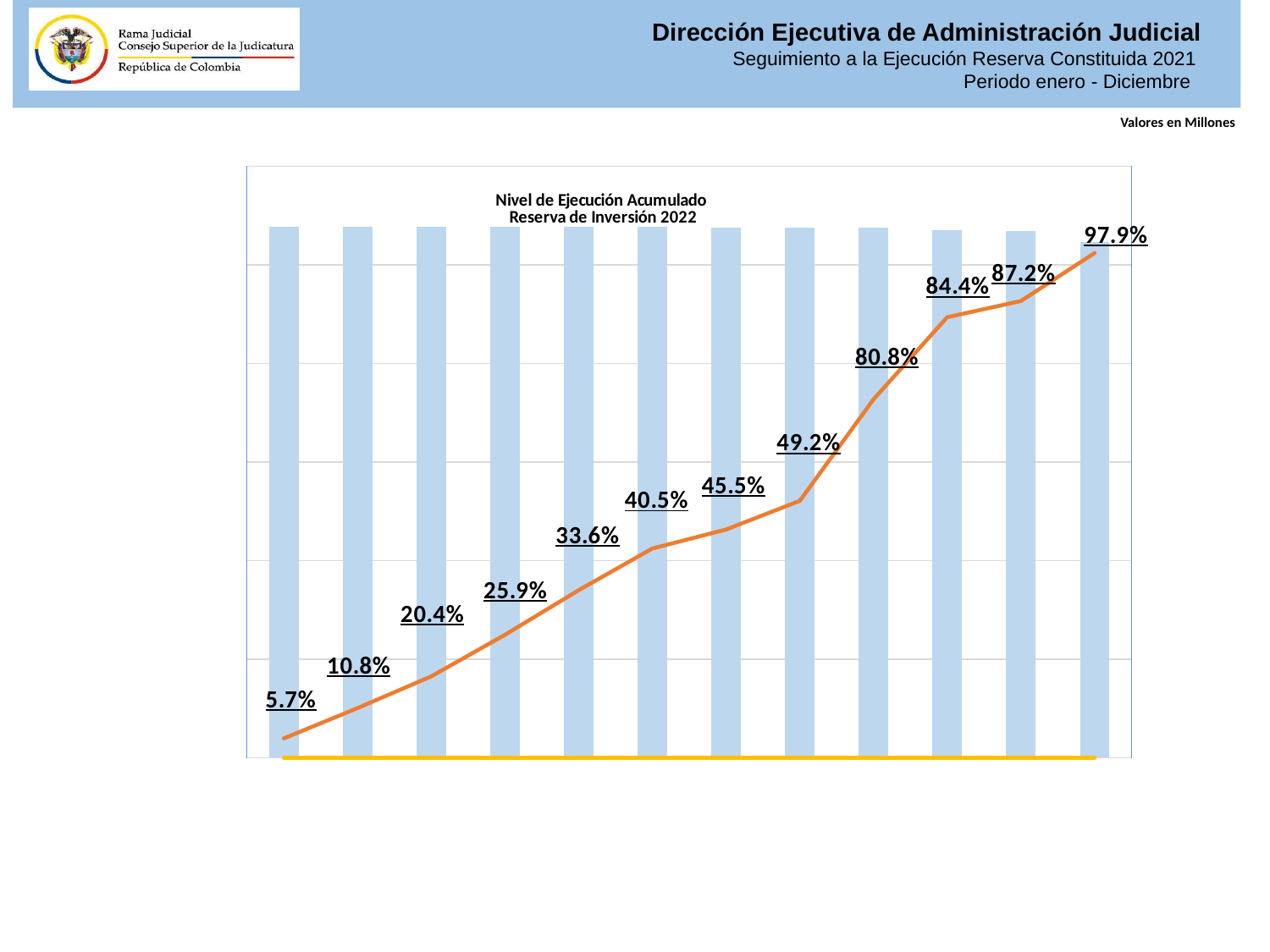
How many data points are labelled on the line? 12 Do the values rise or fall from left to right along the line? rise What is the value of the fifth data point on the line? 33.6% What is the value of the first data point on the line? 5.7% What is the difference between the ninth data point (80.8%) and the eighth data point (49.2%)? 31.6 percentage points What is the lowest value labelled on the line? 5.7% What is the title of the chart? Nivel de Ejecución Acumulado Reserva de Inversión 2022 What is the value of the ninth data point on the line? 80.8% What is the highest value labelled on the line? 97.9% What is the value of the last data point on the line? 97.9% What colour is the line plotted on the chart? orange What is the difference between the last data point (97.9%) and the first data point (5.7%)? 92.2 percentage points